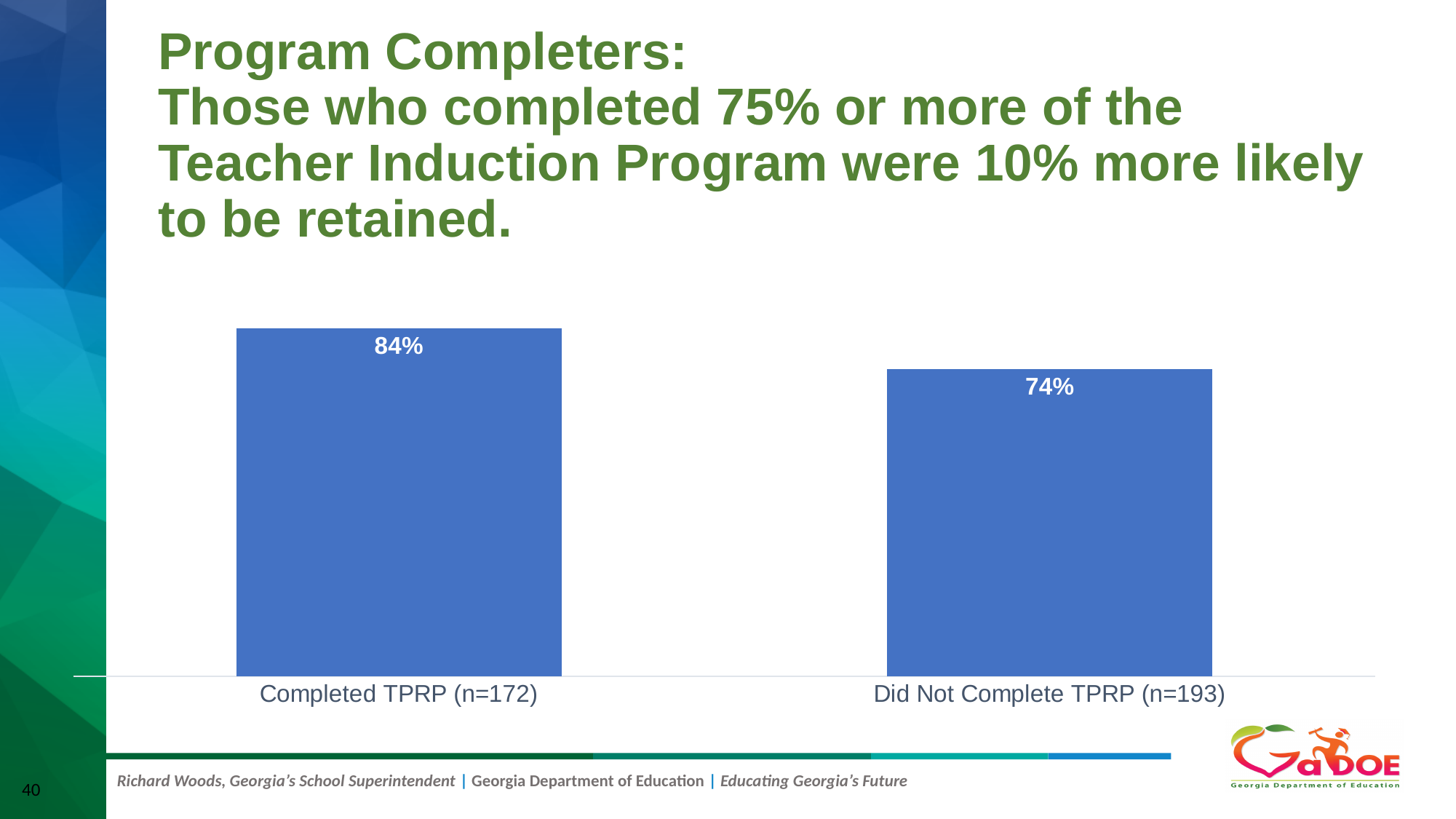
How many teachers are in the Did Not Complete TPRP group according to the category label? 193 Which is larger, the value for Completed TPRP (n=172) or the value for Did Not Complete TPRP (n=193)? Completed TPRP (n=172) What colour are the bars in the chart? Blue What is the value for Completed TPRP (n=172)? 84% Do the values rise or fall from left to right across the categories? Fall What is the difference between the values for Completed TPRP (n=172) and Did Not Complete TPRP (n=193)? 10% Which category has the highest value? Completed TPRP (n=172) What kind of chart is shown on the slide? Bar chart Which category has the lowest value? Did Not Complete TPRP (n=193) What is the value for Did Not Complete TPRP (n=193)? 74% How many categories are shown in the chart? 2